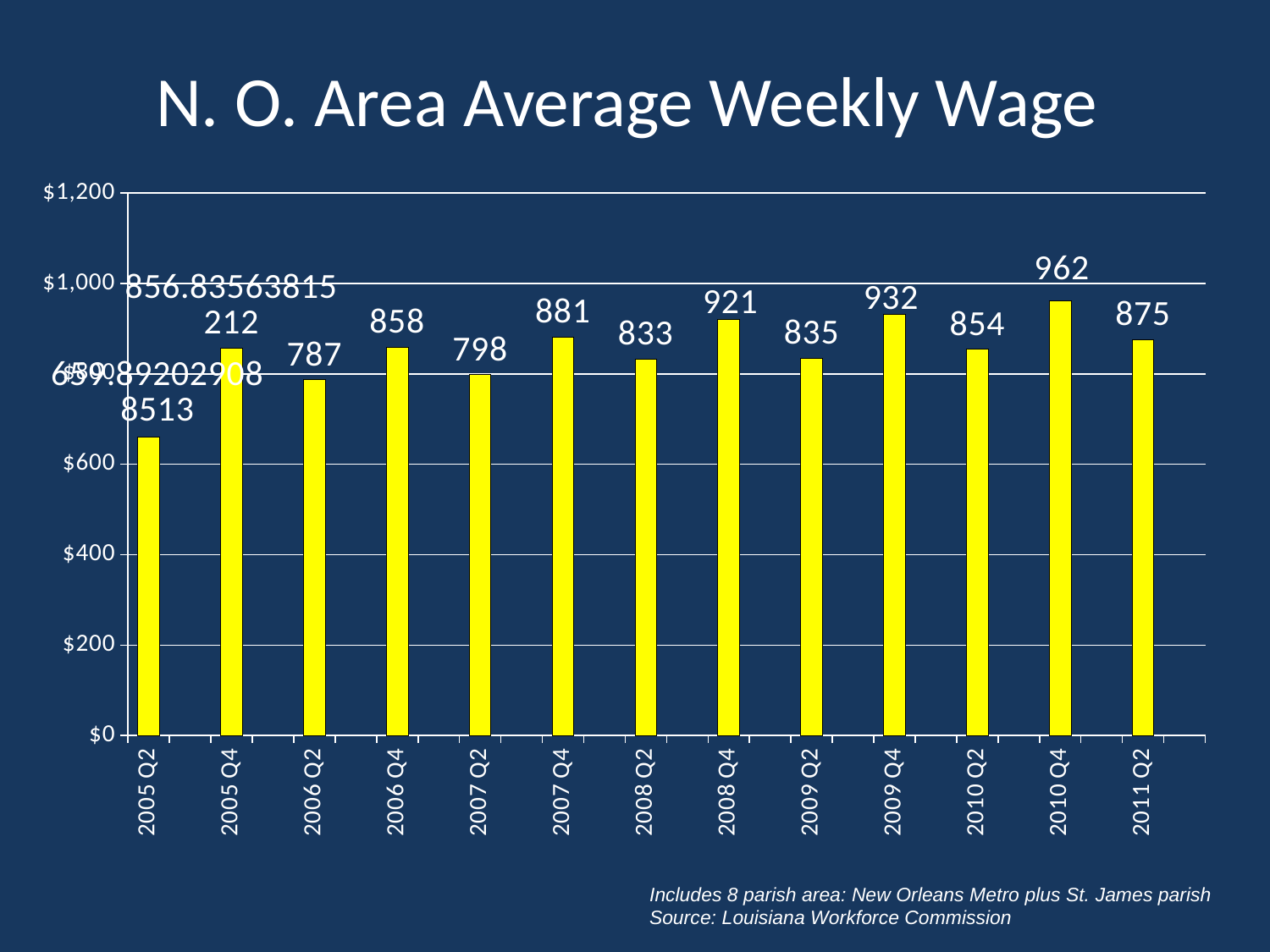
What is the average weekly wage for 2009 Q4? 932 How many quarters are shown on the x axis? 13 Is the value for 2005 Q2 greater or less than $800? less Which quarter has the highest average weekly wage? 2010 Q4 What is the title of the chart? N. O. Area Average Weekly Wage What is the average weekly wage for 2010 Q4? 962 What is the average weekly wage for 2007 Q2? 798 Is the value for 2005 Q2 greater or less than $600? greater What is the difference between the average weekly wage in 2010 Q4 and 2011 Q2? 87 What kind of chart is shown on the slide? bar chart Which is larger, the average weekly wage in 2007 Q4 or in 2008 Q2? 2007 Q4 Which quarter has the lowest average weekly wage? 2005 Q2